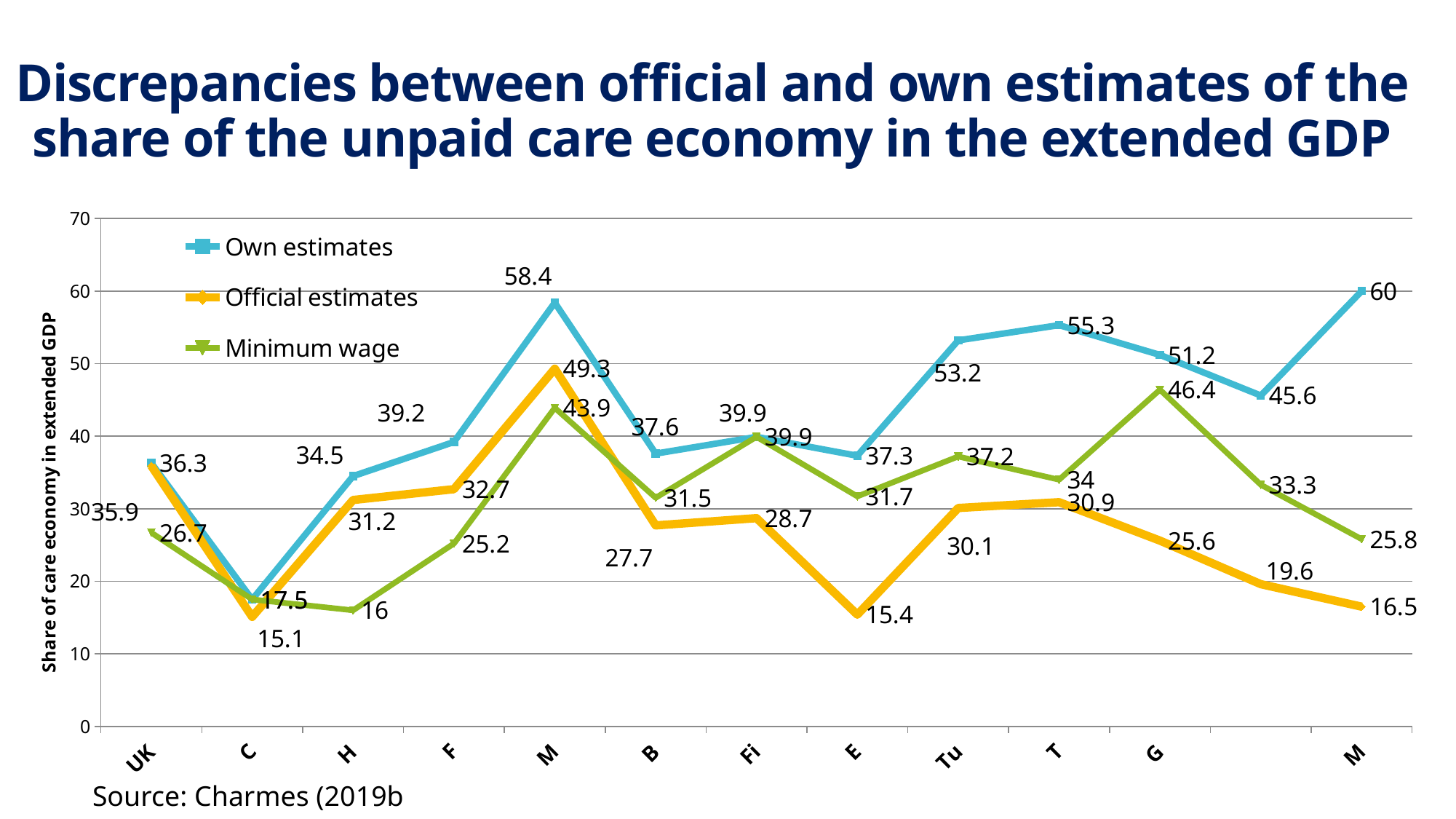
What is the Official estimates value for UK? 35.9 What is the Minimum wage value for G? 46.4 What is the Official estimates value for E? 15.4 What is the Own estimates value for T? 55.3 How many series does the legend list? 3 Which category has the lowest Official estimates value? C What is the difference between the Own estimates and Official estimates values for Tu? 23.1 Which category has the highest Minimum wage value? G What kind of chart is shown on the slide? line chart For B, which is larger: the Own estimates value or the Minimum wage value? Own estimates Between T and the final category M, do the Official estimates values rise or fall? fall Is the Own estimates value for H greater or less than 30? greater